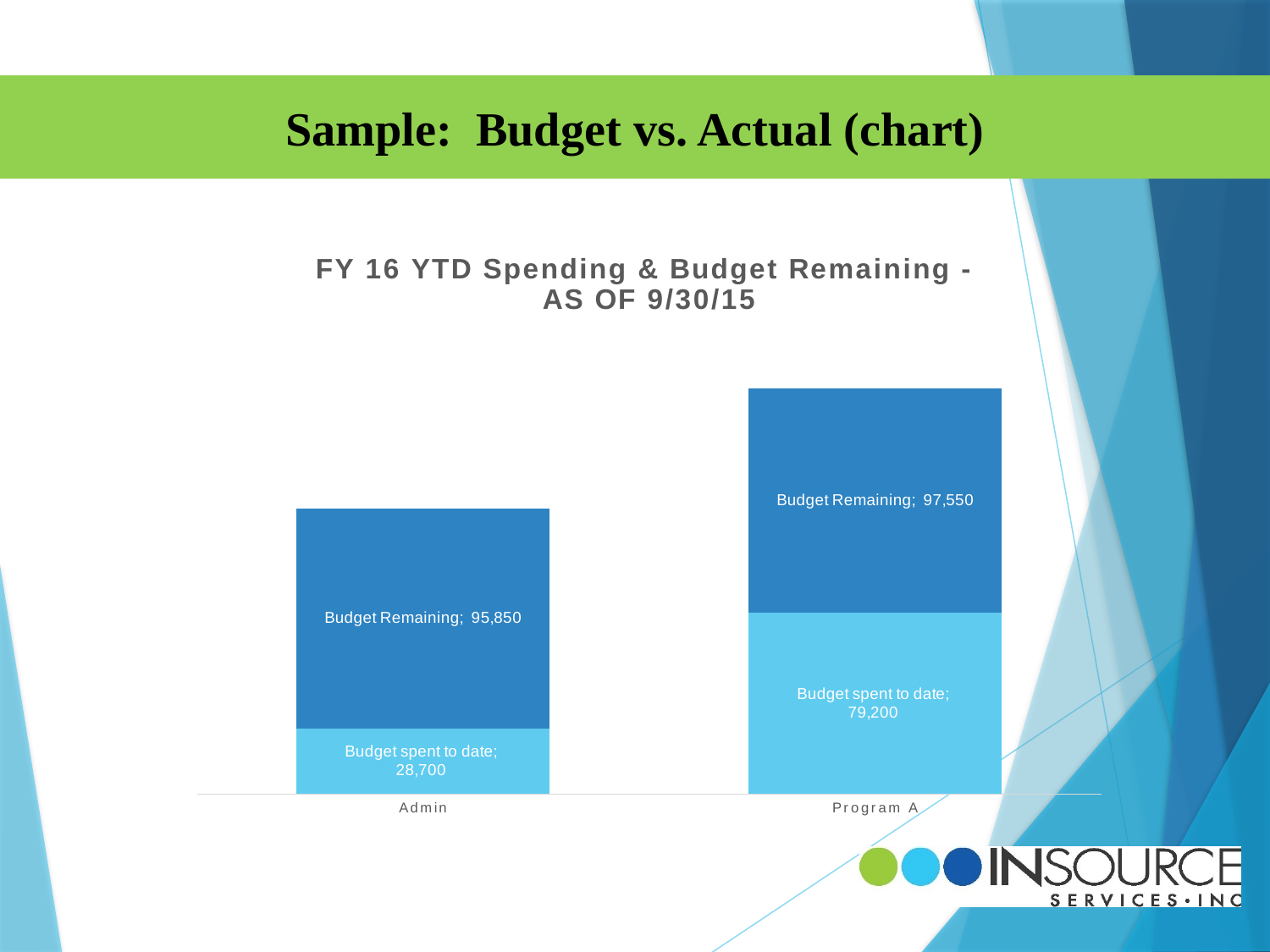
What is the Budget spent to date value for Admin? 28,700 What is the difference in Budget spent to date between Program A and Admin? 50,500 What is the Budget Remaining value for Admin? 95,850 What is the total of the stacked bar for Admin? 124,550 Which category has the lowest Budget spent to date? Admin Which category has the higher Budget spent to date, Admin or Program A? Program A What is the Budget Remaining value for Program A? 97,550 How many categories are shown on the x axis of the chart? 2 What is the total of the stacked bar for Program A? 176,750 What is the Budget spent to date value for Program A? 79,200 What is the difference in Budget Remaining between Program A and Admin? 1,700 What is the title of the chart? FY 16 YTD Spending & Budget Remaining - AS OF 9/30/15